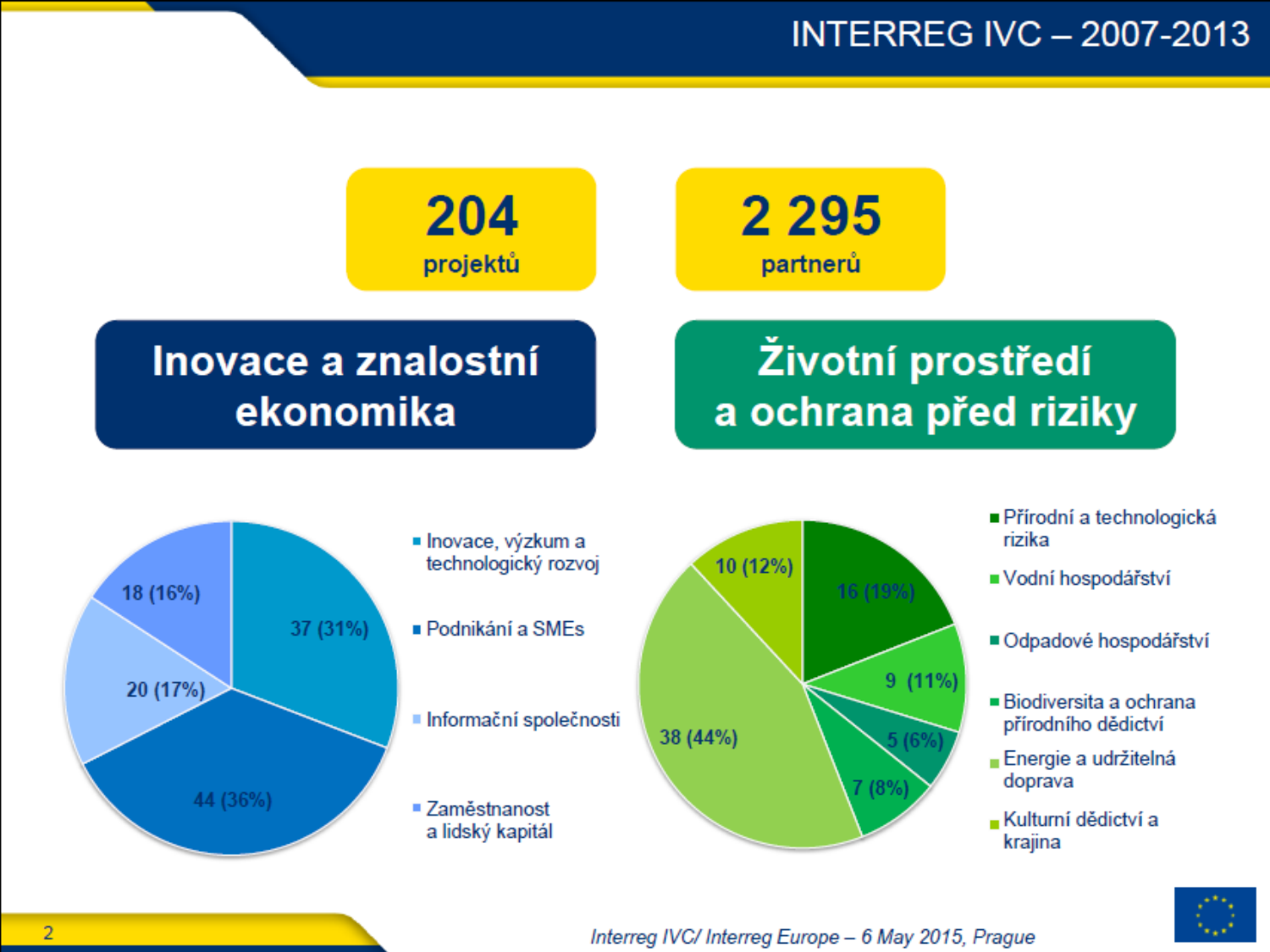
In the 'Životní prostředí a ochrana před riziky' pie chart, what share does 'Kulturní dědictví a krajina' have? 12% In the 'Životní prostředí a ochrana před riziky' pie chart, which category has the largest slice? Energie a udržitelná doprava How many categories does the 'Životní prostředí a ochrana před riziky' pie chart show? 6 In the 'Inovace a znalostní ekonomika' pie chart, what share does 'Inovace, výzkum a technologický rozvoj' have? 31% In the 'Inovace a znalostní ekonomika' pie chart, which category has the smallest slice? Zaměstnanost a lidský kapitál In the 'Životní prostředí a ochrana před riziky' pie chart, which is larger: 'Odpadové hospodářství' or 'Biodiversita a ochrana přírodního dědictví'? Biodiversita a ochrana přírodního dědictví What type of chart is used under 'Životní prostředí a ochrana před riziky'? Pie chart In the 'Životní prostředí a ochrana před riziky' pie chart, what is the difference between 'Energie a udržitelná doprava' and 'Přírodní a technologická rizika' counts? 22 How many categories does the 'Inovace a znalostní ekonomika' pie chart show? 4 In the 'Inovace a znalostní ekonomika' pie chart, how many projects are in 'Podnikání a SMEs'? 44 In the 'Inovace a znalostní ekonomika' pie chart, what is the difference between the 'Podnikání a SMEs' and 'Informační společnosti' counts? 24 In the 'Životní prostředí a ochrana před riziky' pie chart, how many projects are in 'Vodní hospodářství'? 9